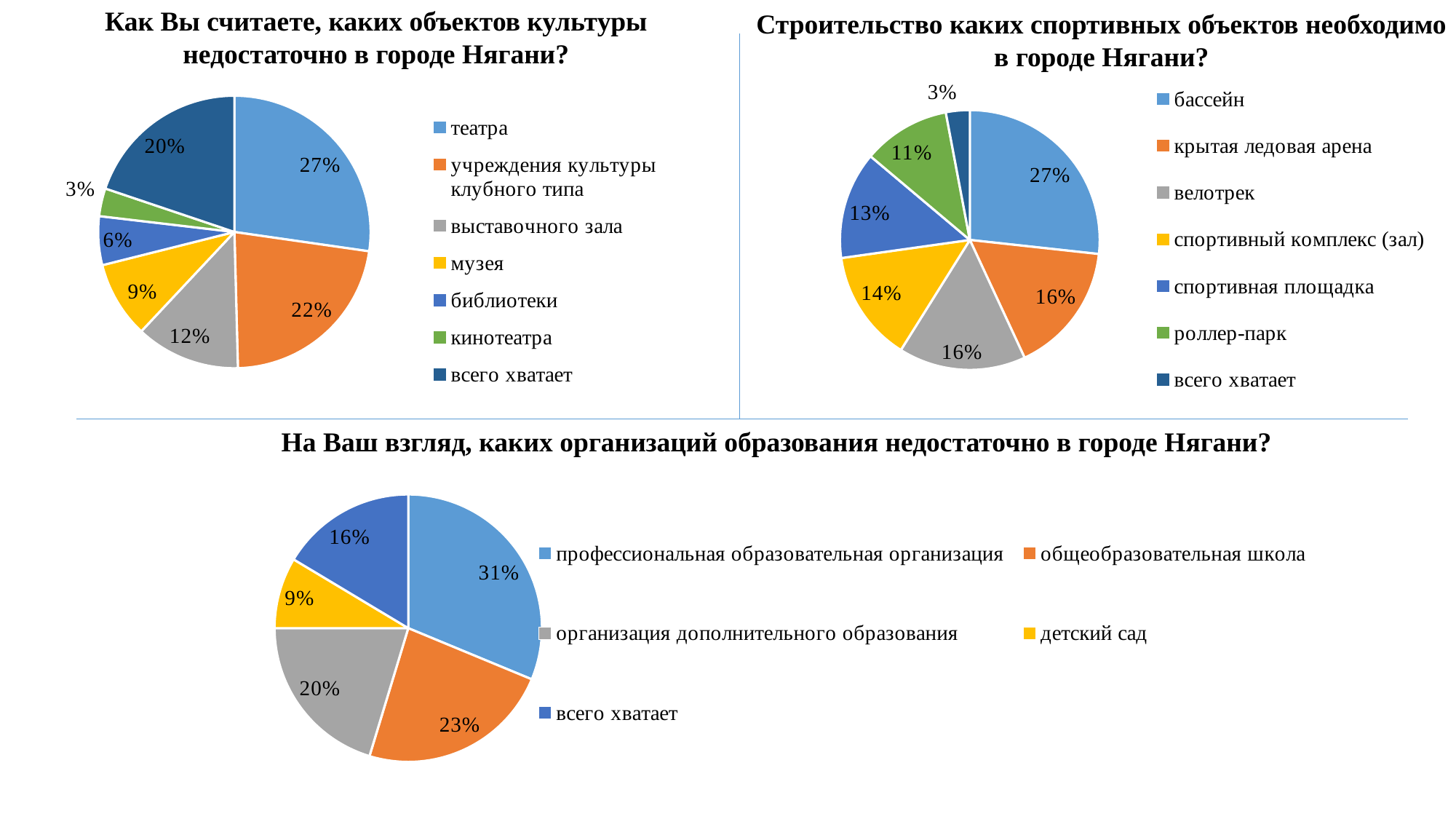
In the top-left chart about cultural facilities, what share is shown for 'библиотеки'? 6% In the top-right chart about sports facilities, what share is shown for 'спортивный комплекс (зал)'? 14% In the top-left chart about cultural facilities in Nyagan, what share of respondents chose 'театра'? 27% In the bottom chart about educational organizations, what share is shown for 'общеобразовательная школа'? 23% What type of chart is the bottom chart about educational organizations? pie chart In the top-left chart about cultural facilities, what is the difference between the shares for 'учреждения культуры клубного типа' and 'выставочного зала'? 10% In the top-right chart about sports facilities, which category has the largest share? бассейн In the top-right chart about sports facilities, what share is shown for 'всего хватает'? 3% In the top-left chart about cultural facilities, how many categories does the legend list? 7 In the top-right chart about sports facilities, which is larger: the share for 'спортивная площадка' or for 'роллер-парк'? спортивная площадка In the top-left chart about cultural facilities, which category has the smallest share? кинотеатра In the bottom chart about educational organizations, which category has the largest share? профессиональная образовательная организация